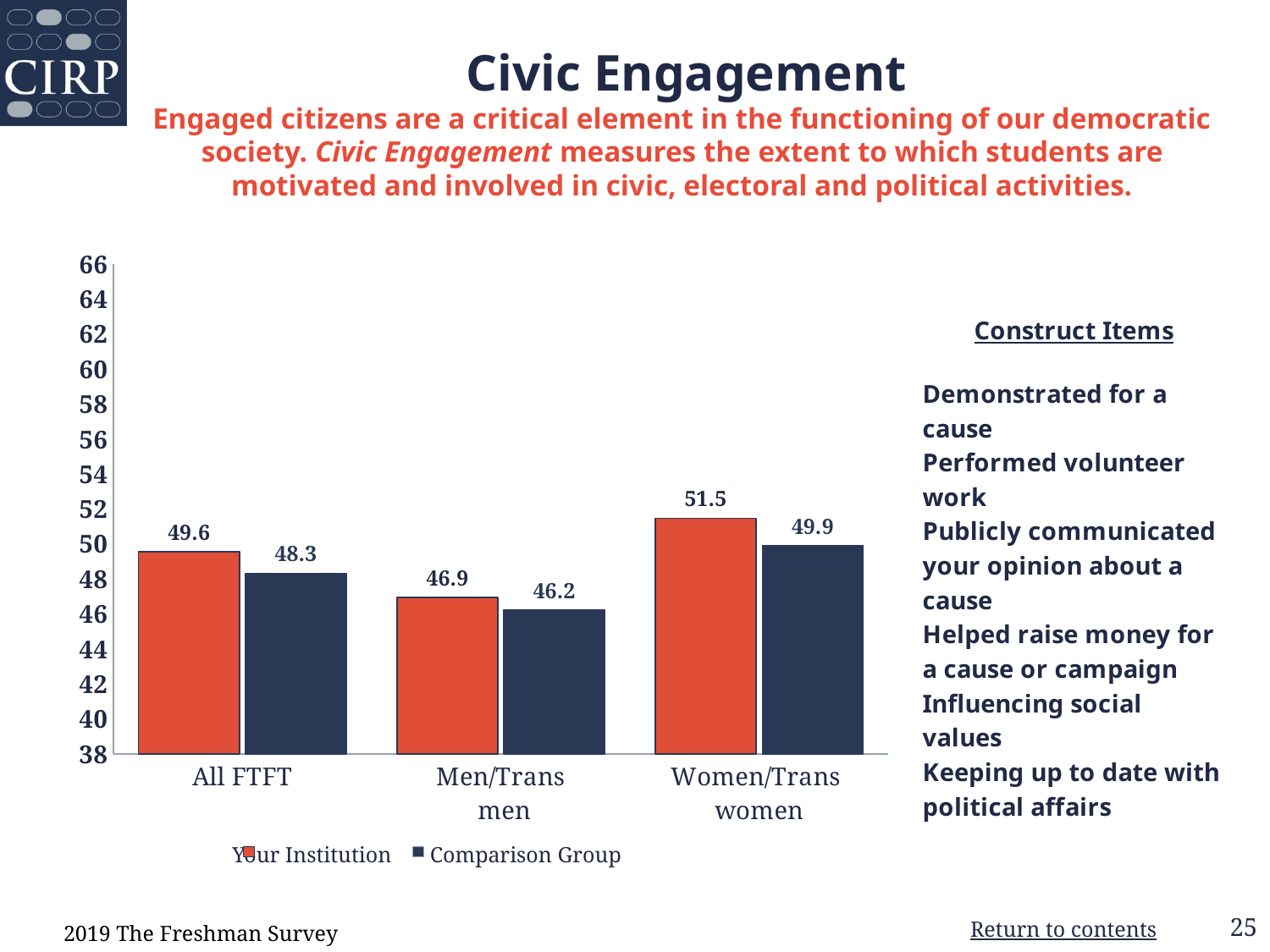
Which category has the lowest Comparison Group value? Men/Trans men Which category has the highest Your Institution value? Women/Trans women What is the difference between the Your Institution and Comparison Group values for All FTFT? 1.3 What is the Comparison Group value for Women/Trans women? 49.9 What kind of chart is shown on the slide? bar chart Is the Comparison Group value for All FTFT greater or less than 50? less How many series does the legend list? 2 What is the Your Institution value for Women/Trans women? 51.5 What is the Your Institution value for All FTFT? 49.6 Which is larger for Men/Trans men: Your Institution or Comparison Group? Your Institution What is the Comparison Group value for Men/Trans men? 46.2 How many categories are shown on the x axis? 3